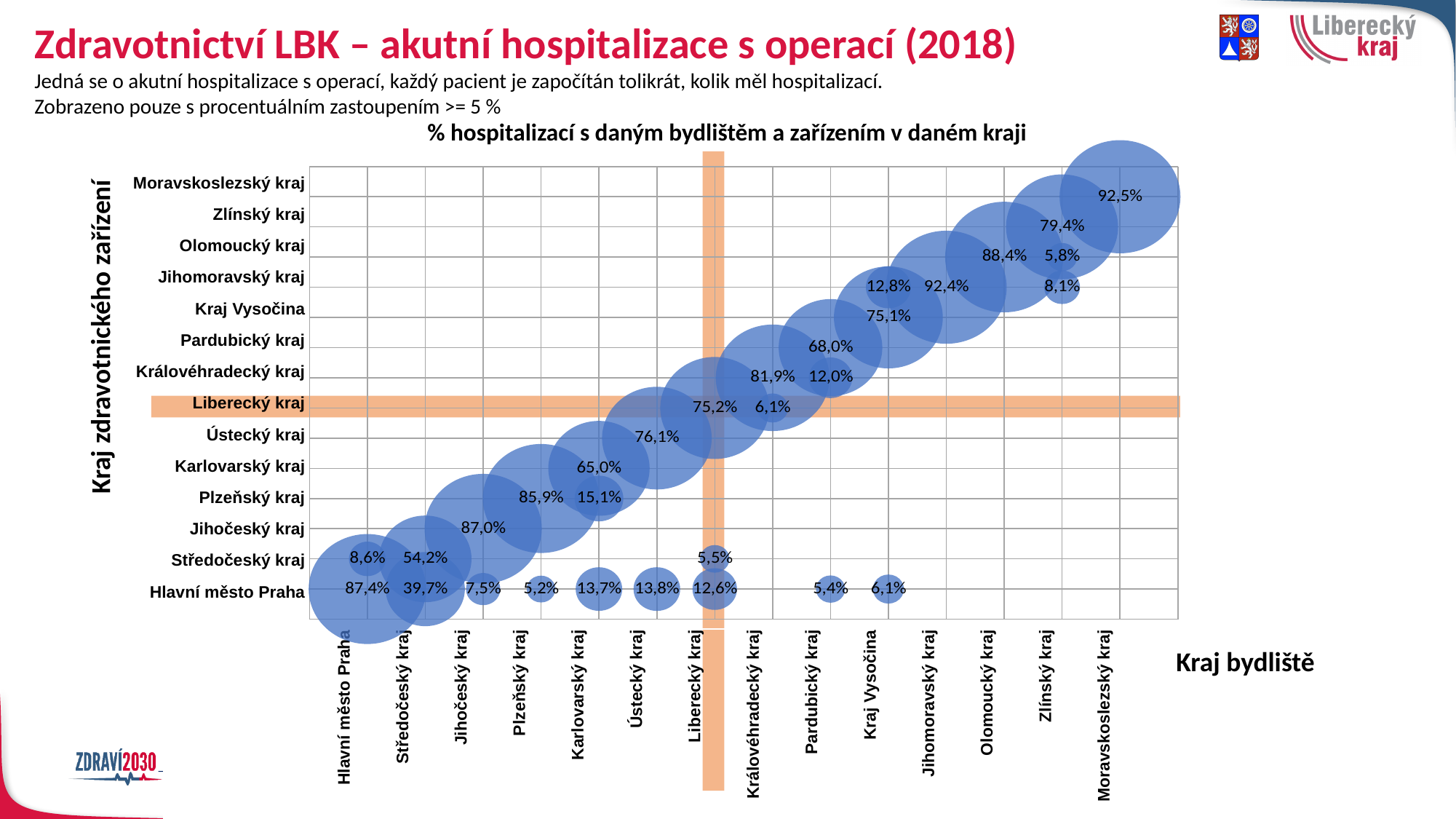
Which is larger: the percentage for Jihočeský kraj residents hospitalised in Jihočeský kraj, or Plzeňský kraj residents hospitalised in Plzeňský kraj? Jihočeský kraj (87,0%) How many regions are listed on the vertical axis (Kraj zdravotnického zařízení)? 14 Which data label shows the highest percentage on the chart? 92,5% What is the difference between the percentage for Hlavní město Praha residents hospitalised in Praha (87,4%) and Středočeský kraj residents hospitalised in Praha (39,7%)? 47,7 percentage points What percentage is shown for patients living in Pardubický kraj hospitalised in a facility in Královéhradecký kraj? 12,0% What percentage is shown for patients living in Moravskoslezský kraj hospitalised in a facility in Moravskoslezský kraj? 92,5% Which data label shows the lowest percentage on the chart? 5,2% What is the chart's title? % hospitalizací s daným bydlištěm a zařízením v daném kraji What percentage is shown for patients living in Karlovarský kraj hospitalised in a facility in Plzeňský kraj? 15,1% What percentage is shown for patients living in Liberecký kraj hospitalised in a facility in Liberecký kraj? 75,2% What percentage is shown for patients living in Středočeský kraj hospitalised in a facility in Hlavní město Praha? 39,7% What type of chart is shown on the slide? Bubble chart